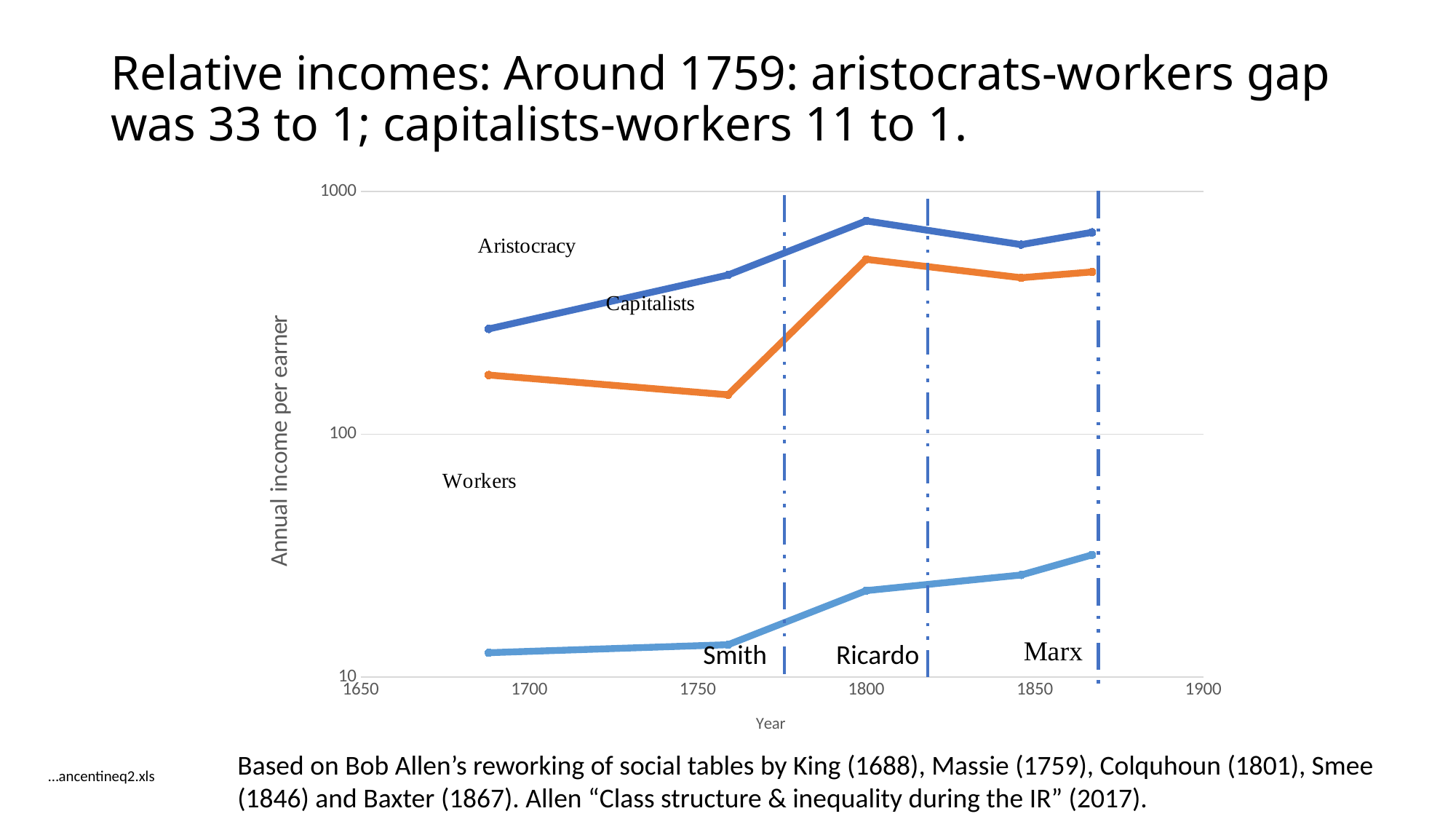
Does the Capitalists line rise or fall between its first and second points (1688 to 1759)? fall How many series are plotted on the chart? 3 Is the value for Workers around 1688 greater or less than 100? less What is the title of the vertical axis? Annual income per earner What kind of chart is shown on the slide? line chart Do the Workers values rise or fall from 1688 to 1867? rise Around 1688, which is larger: the Aristocracy value or the Capitalists value? Aristocracy Is the value for Aristocracy around 1688 greater or less than 100? greater Which series has the highest values throughout the chart? Aristocracy Is the peak value for Aristocracy around 1800 greater or less than 1000? less Which series has the lowest values throughout the chart? Workers How many data points does the Workers line have? 5